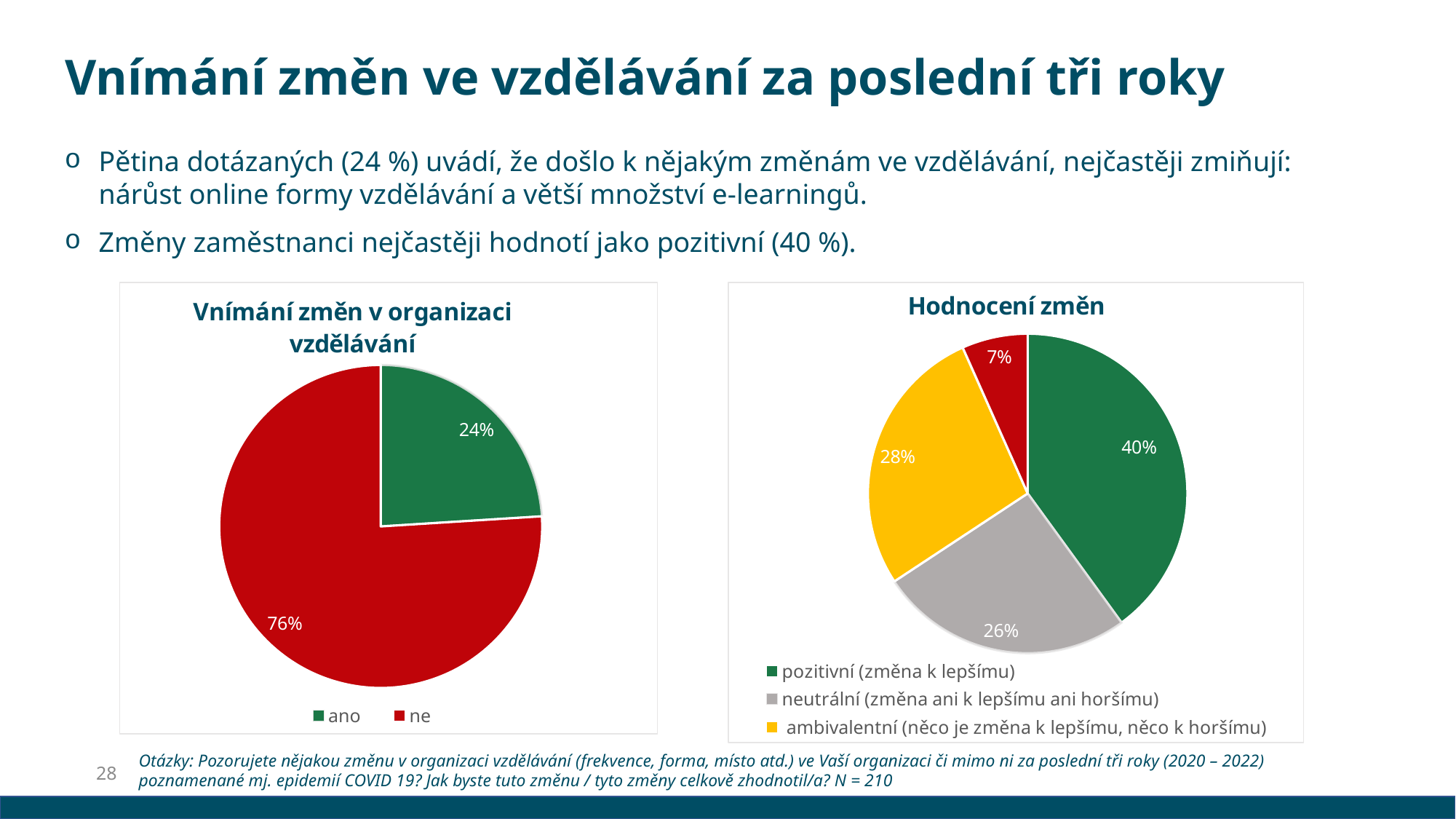
In the chart titled "Hodnocení změn", what share is labelled for "ambivalentní (něco je změna k lepšímu, něco k horšímu)"? 28% In the chart titled "Hodnocení změn", how many entries does the legend list? 3 In the chart titled "Vnímání změn v organizaci vzdělávání", what share of respondents answered "ne"? 76% In the chart titled "Vnímání změn v organizaci vzdělávání", what is the difference in percentage points between "ne" and "ano"? 52 In the chart titled "Hodnocení změn", how many slices does the pie have? 4 In the chart titled "Hodnocení změn", what share is labelled for "neutrální (změna ani k lepšímu ani horšímu)"? 26% In the chart titled "Vnímání změn v organizaci vzdělávání", which category has the larger share? ne In the chart titled "Vnímání změn v organizaci vzdělávání", what share of respondents answered "ano"? 24% In the chart titled "Hodnocení změn", which is larger: the "neutrální" slice or the "ambivalentní" slice? ambivalentní In the chart titled "Hodnocení změn", which legend category has the largest slice? pozitivní (změna k lepšímu) What type of chart is the chart titled "Vnímání změn v organizaci vzdělávání"? pie chart In the chart titled "Hodnocení změn", what share is labelled for "pozitivní (změna k lepšímu)"? 40%